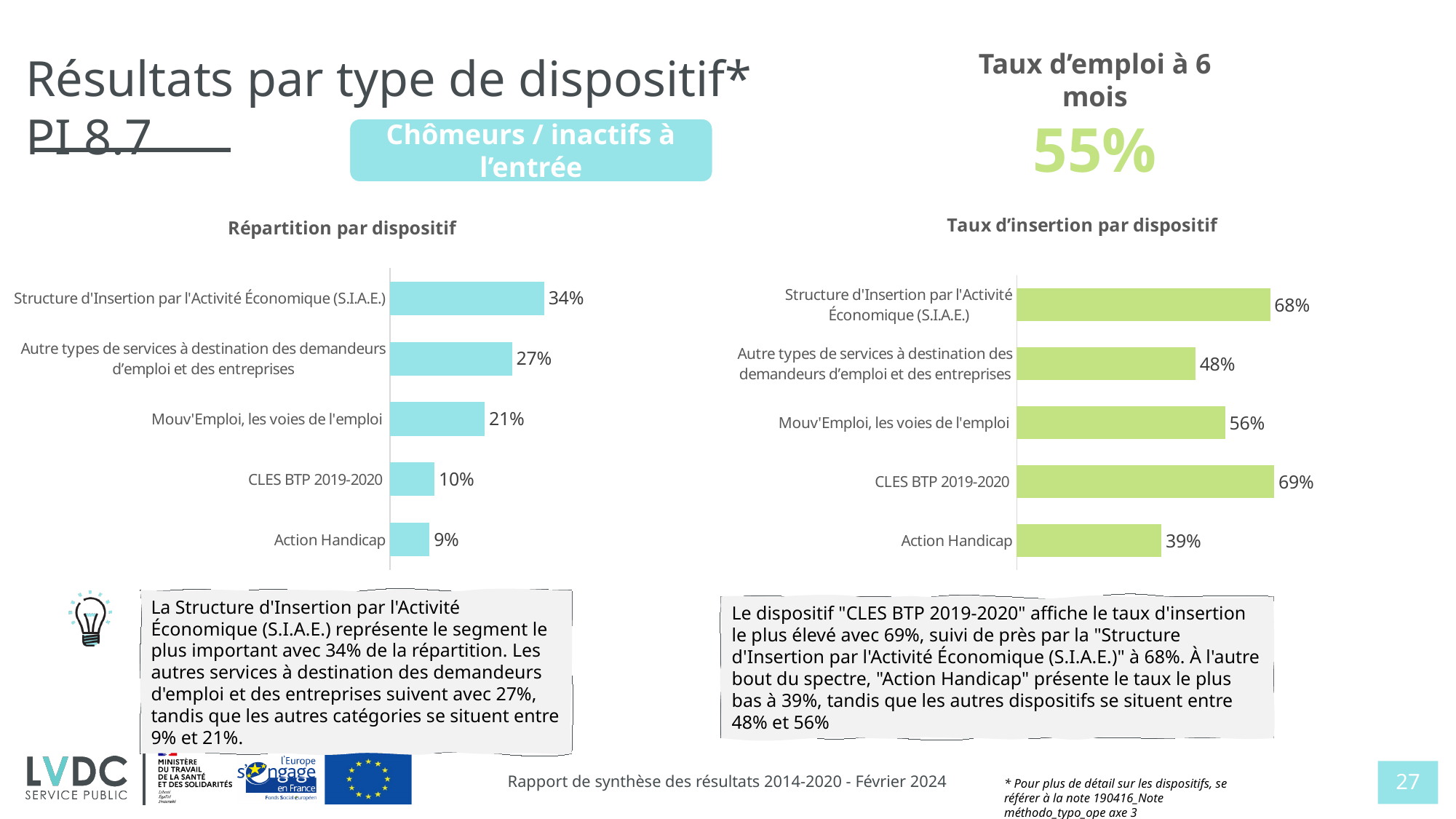
What kind of chart is the 'Taux d'insertion par dispositif' chart? Bar chart In the 'Répartition par dispositif' chart, what is the difference between the values for Structure d'Insertion par l'Activité Économique (S.I.A.E.) and Autre types de services à destination des demandeurs d'emploi et des entreprises? 7% In the 'Taux d'insertion par dispositif' chart, what is the value for Action Handicap? 39% How many categories are shown in the 'Répartition par dispositif' chart? 5 What colour are the bars in the 'Répartition par dispositif' chart? Light blue In the 'Taux d'insertion par dispositif' chart, what is the difference between the values for Mouv'Emploi, les voies de l'emploi and Autre types de services à destination des demandeurs d'emploi et des entreprises? 8% In the 'Taux d'insertion par dispositif' chart, which category has the lowest value? Action Handicap In the 'Taux d'insertion par dispositif' chart, which category has the highest value? CLES BTP 2019-2020 In the 'Répartition par dispositif' chart, what is the value for Mouv'Emploi, les voies de l'emploi? 21% In the 'Répartition par dispositif' chart, what is the value for CLES BTP 2019-2020? 10% In the 'Répartition par dispositif' chart, which category has the lowest value? Action Handicap In the 'Taux d'insertion par dispositif' chart, which is larger: the value for Mouv'Emploi, les voies de l'emploi or the value for Action Handicap? Mouv'Emploi, les voies de l'emploi